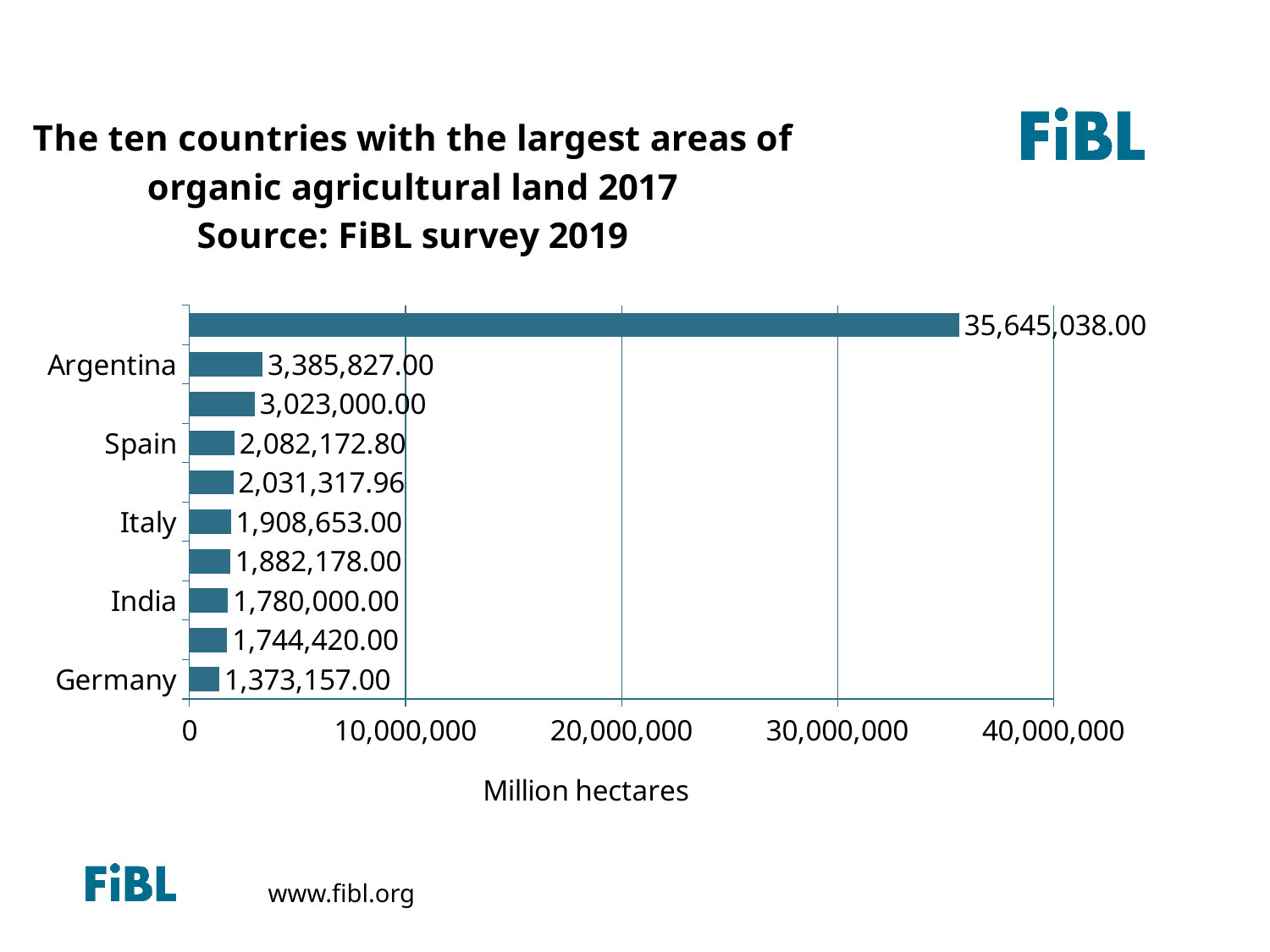
What is the value for Italy? 1,908,653.00 What is the difference between the values for India and Germany? 406,843.00 What is the value for India? 1,780,000.00 What is the difference between the values for Argentina and Spain? 1,303,654.20 What is the value for Germany? 1,373,157.00 Which labelled country has the lowest value? Germany Is the value for Argentina greater or less than 10,000,000? less How many bars are plotted in the chart? 10 What is the value for Argentina? 3,385,827.00 What is the value for Spain? 2,082,172.80 Which is larger, the value for Spain or the value for Italy? Spain What kind of chart is shown on the slide? bar chart